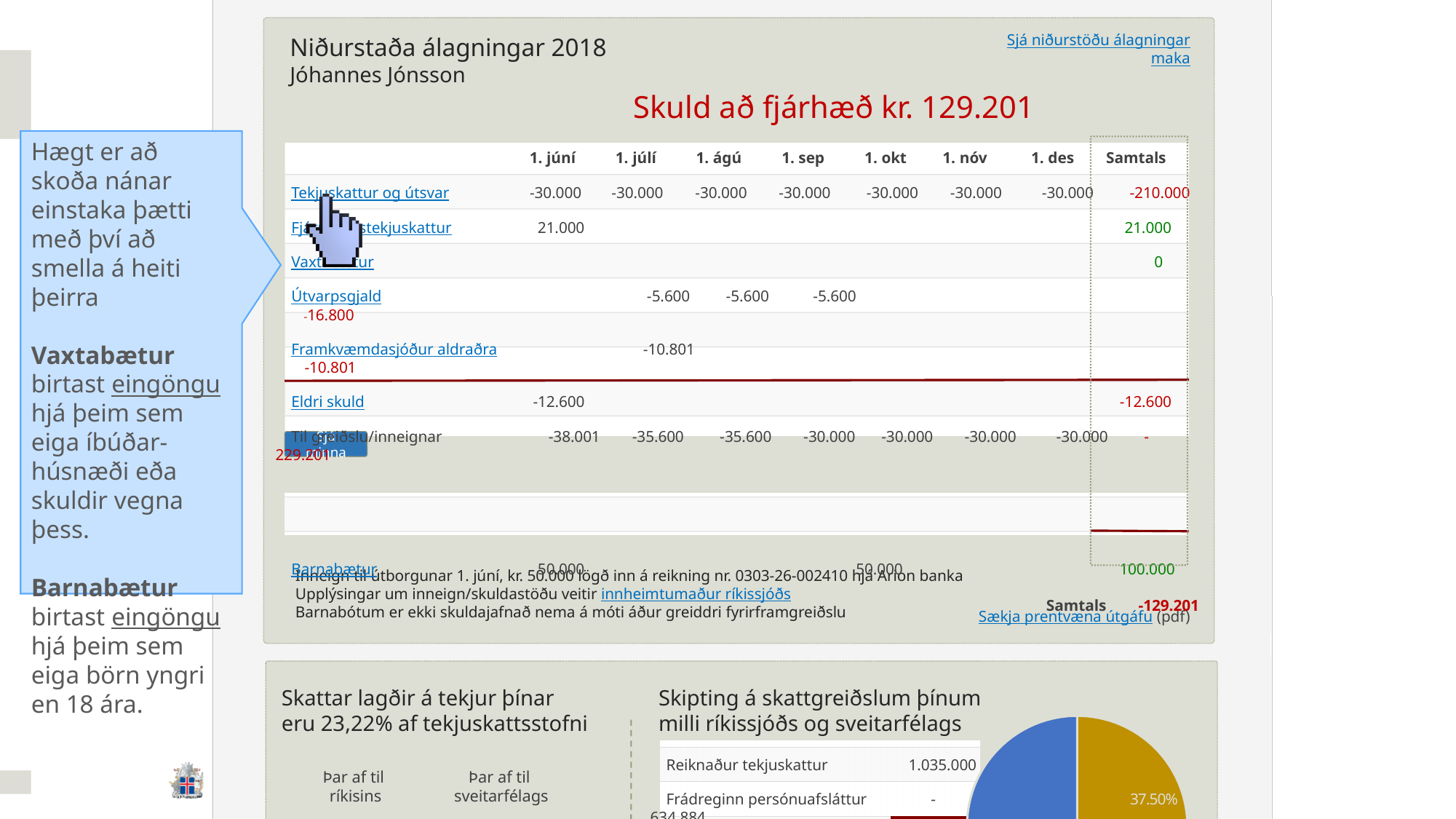
In the pie chart at the bottom right, what percentage is printed on the gold slice? 37.50% In the pie chart at the bottom right, is the share of the gold slice greater or less than 50%? less What kind of chart is shown at the bottom right of the slide? pie chart What is the title above the pie chart at the bottom right of the slide? Skipting á skattgreiðslum þínum milli ríkissjóðs og sveitarfélags In the table at the top of the slide, what is the Samtals value for Tekjuskattur og útsvar? -210.000 In the table next to the pie chart, what is the value for Reiknaður tekjuskattur? 1.035.000 In the table at the top of the slide, what is the Samtals value for Barnabætur? 100.000 In the table at the top of the slide, what is the Samtals value for Eldri skuld? -12.600 In the table at the top of the slide, what is the overall Samtals amount shown at the bottom right? -129.201 Which two colours are used for the slices of the pie chart at the bottom right? blue and gold